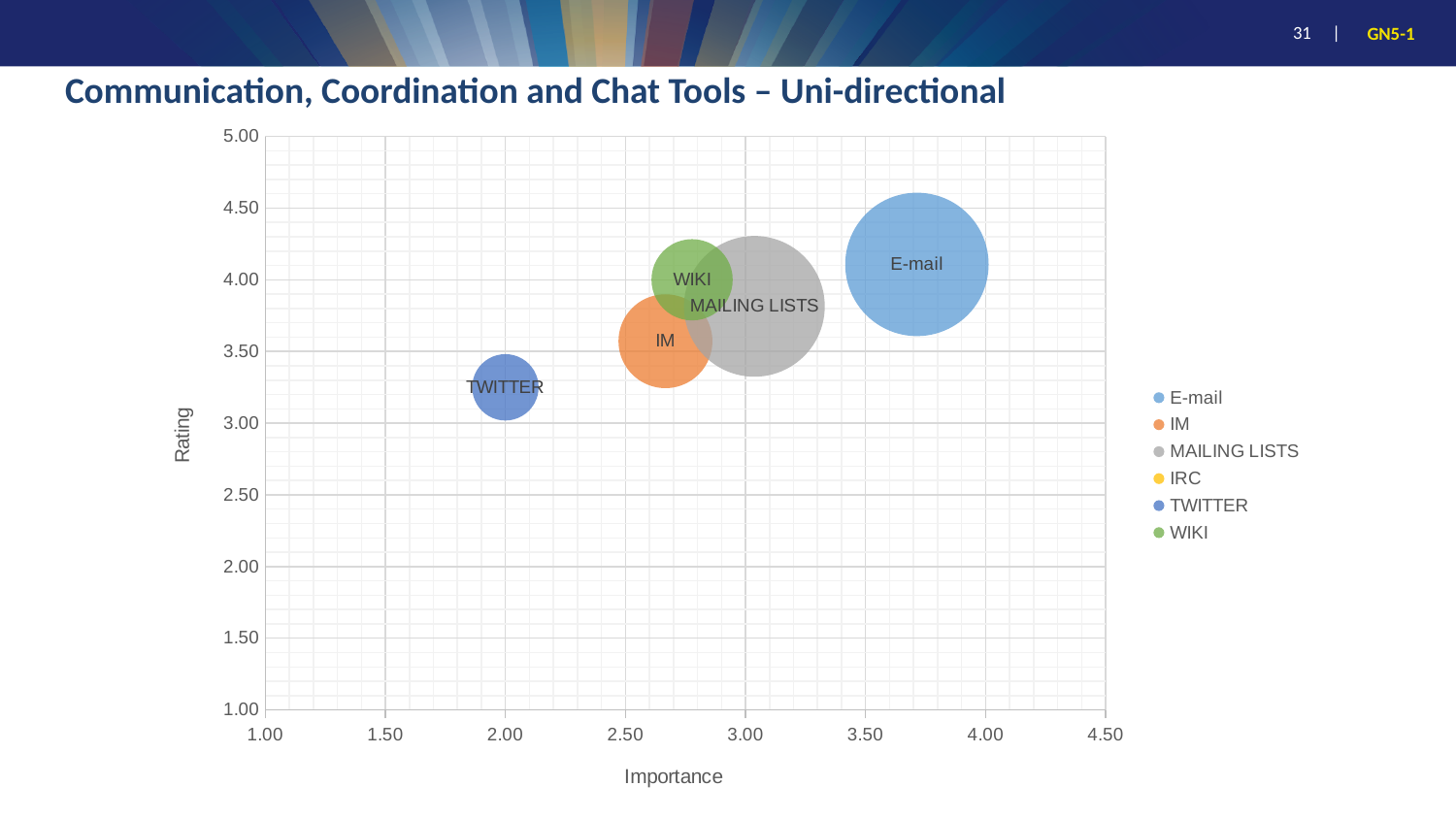
How many series does the legend list? 6 What is the title of the horizontal axis? Importance Is the Importance value for E-mail greater or less than 3.50? greater Is the Rating value for WIKI greater or less than 3.50? greater Which tool has the highest Importance value? E-mail Which tool has the lowest Rating value? TWITTER Which tool has the lowest Importance value? TWITTER Which has the higher Rating value, E-mail or IM? E-mail Is the Rating value for TWITTER greater or less than 3.50? less Which has the higher Importance value, E-mail or TWITTER? E-mail What kind of chart is shown on the slide? Bubble chart